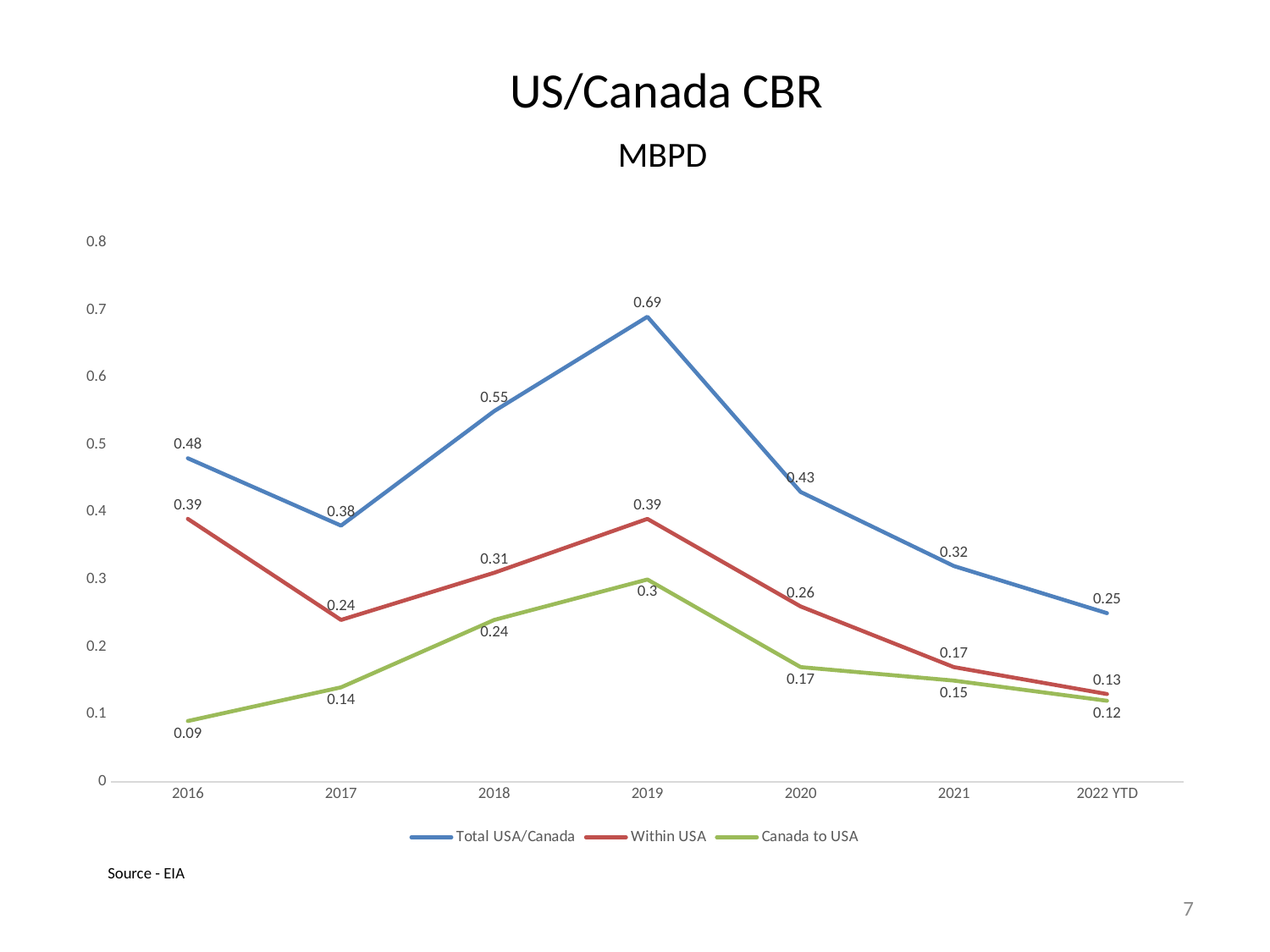
How many series does the legend list? 3 Which is larger in 2017: Within USA or Canada to USA? Within USA What is the value for Canada to USA in 2016? 0.09 In which year is the Total USA/Canada series highest? 2019 How many years are shown on the x axis? 7 What is the value for Within USA in 2020? 0.26 What kind of chart is shown on the slide? Line chart Does the Total USA/Canada series rise or fall from 2019 to 2022 YTD? Fall What is the difference between Total USA/Canada in 2019 and in 2020? 0.26 In which year is the Canada to USA series lowest? 2016 Is the value for Total USA/Canada in 2018 greater or less than 0.5? greater What is the value for Total USA/Canada in 2019? 0.69